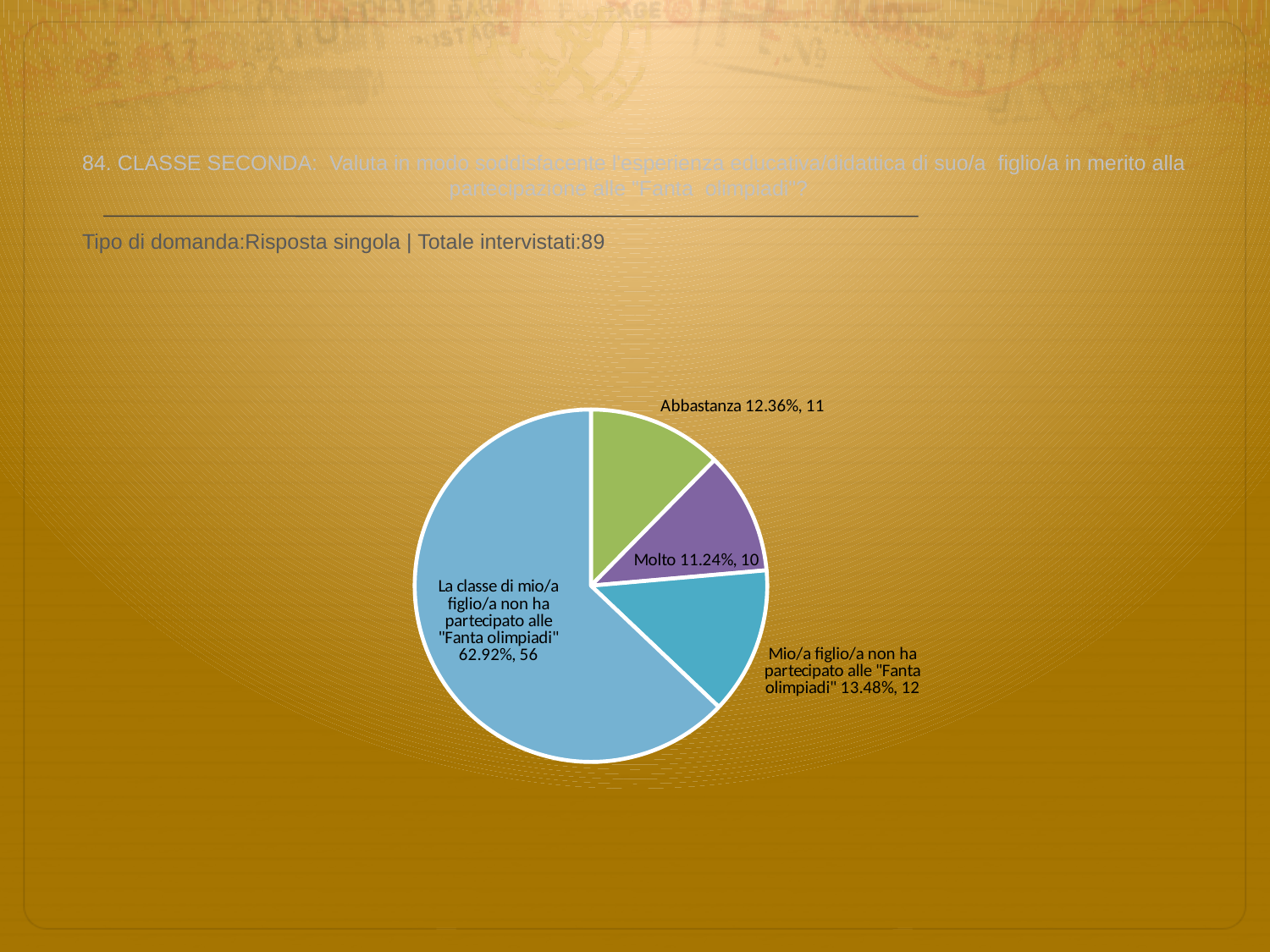
How many slices does the pie chart have? 4 What is the difference in count between the "Abbastanza" slice and the "Molto" slice? 1 What count is shown for the "Molto" slice? 10 What percentage share does the "Mio/a figlio/a non ha partecipato alle "Fanta olimpiadi"" slice have? 13.48% What percentage share does the "Abbastanza" slice have? 12.36% Which slice is the smallest in the pie chart? Molto What kind of chart is shown on the slide? pie chart What is the total number of respondents across all slices of the pie chart? 89 What colour is the "Molto" slice in the pie chart? purple Which has a larger count, "Abbastanza" or "Mio/a figlio/a non ha partecipato alle "Fanta olimpiadi""? Mio/a figlio/a non ha partecipato alle "Fanta olimpiadi" What count is shown for the "La classe di mio/a figlio/a non ha partecipato alle "Fanta olimpiadi"" slice? 56 Which slice is the largest in the pie chart? La classe di mio/a figlio/a non ha partecipato alle "Fanta olimpiadi"